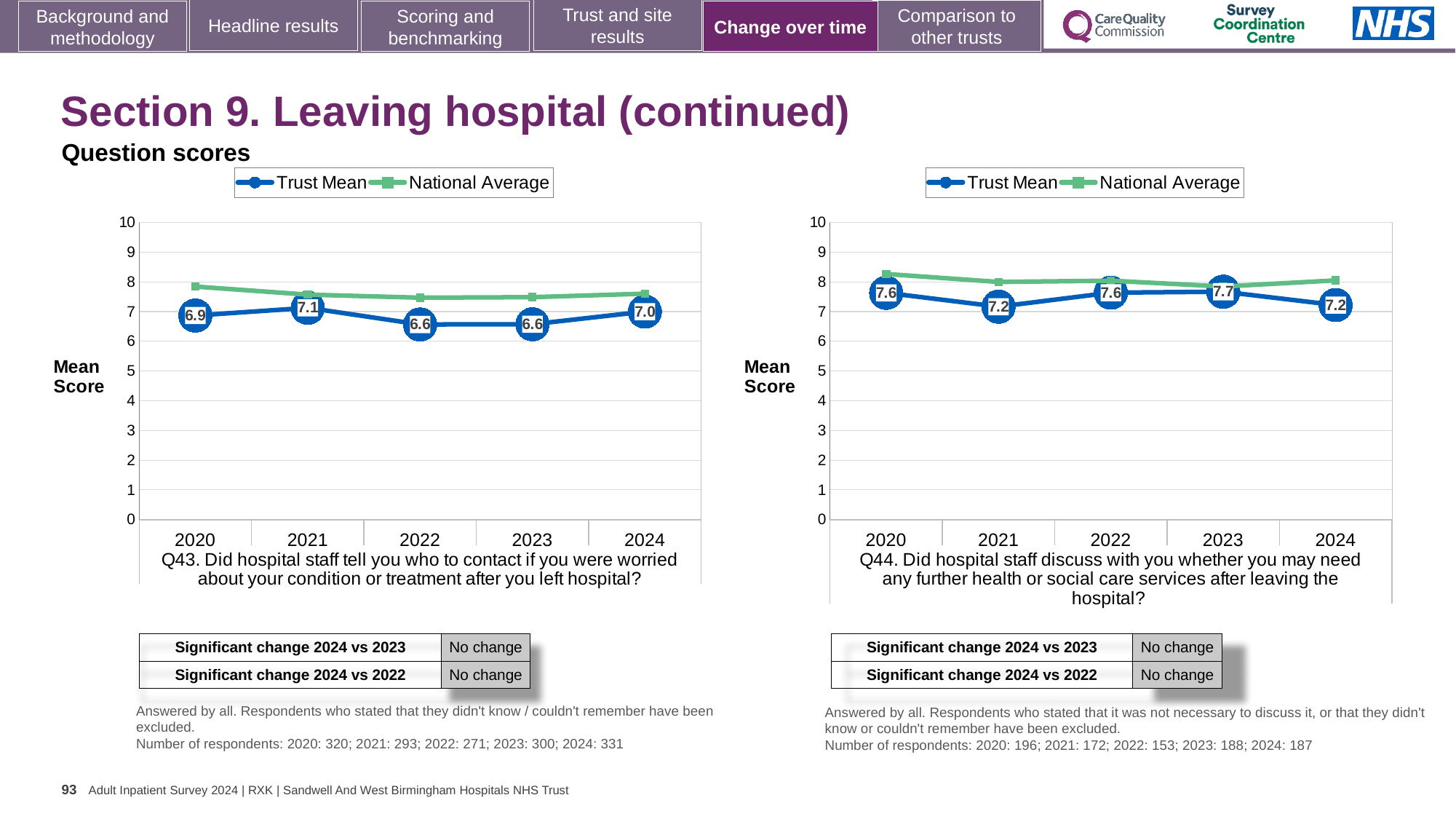
In the Q44 chart (right), what is the Trust Mean score for 2023? 7.7 In the Q44 chart (right), what is the difference between the Trust Mean scores for 2023 and 2024? 0.5 In the Q43 chart (left), what is the Trust Mean score for 2022? 6.6 What type of chart is used for Q43 (left)? Line chart In the Q44 chart (right), which year has the highest Trust Mean score? 2023 In the Q43 chart (left), is the National Average value for 2020 greater or less than 7? greater In the Q43 chart (left), what is the difference between the Trust Mean scores for 2021 and 2022? 0.5 In the Q43 chart (left), which year has the highest Trust Mean score? 2021 How many years are shown on the x axis of the Q43 chart (left)? 5 In the Q44 chart (right), is the Trust Mean score higher in 2020 or in 2021? 2020 In the Q44 chart (right), is the National Average value for 2022 greater or less than 7? greater How many series does the legend of the Q44 chart (right) list? 2